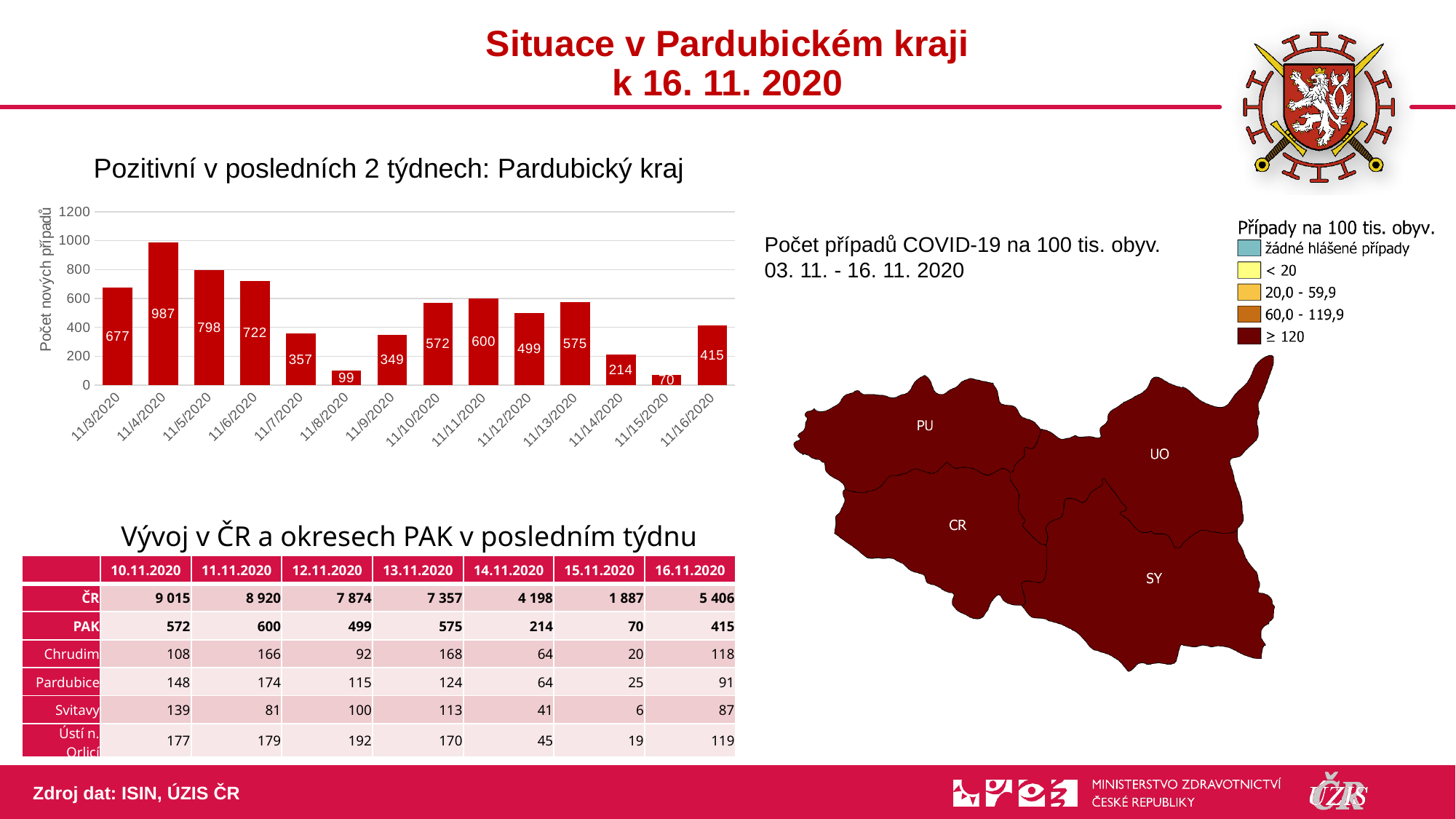
In the chart 'Pozitivní v posledních 2 týdnech: Pardubický kraj', which date has the lowest value? 11/15/2020 In the chart 'Pozitivní v posledních 2 týdnech: Pardubický kraj', is the value for 11/3/2020 greater or less than 600? greater In the chart 'Pozitivní v posledních 2 týdnech: Pardubický kraj', what is the value for 11/8/2020? 99 What type of chart is used for 'Pozitivní v posledních 2 týdnech: Pardubický kraj'? bar chart In the chart 'Pozitivní v posledních 2 týdnech: Pardubický kraj', which date has the highest value? 11/4/2020 In the chart 'Pozitivní v posledních 2 týdnech: Pardubický kraj', do the values rise or fall from 11/13/2020 to 11/15/2020? fall In the chart 'Pozitivní v posledních 2 týdnech: Pardubický kraj', what is the difference between the values for 11/4/2020 and 11/3/2020? 310 What is the y-axis title of the chart 'Pozitivní v posledních 2 týdnech: Pardubický kraj'? Počet nových případů How many dates (bars) are shown in the chart 'Pozitivní v posledních 2 týdnech: Pardubický kraj'? 14 In the chart 'Pozitivní v posledních 2 týdnech: Pardubický kraj', what is the value for 11/16/2020? 415 In the chart 'Pozitivní v posledních 2 týdnech: Pardubický kraj', which is larger, the value for 11/5/2020 or 11/6/2020? 11/5/2020 In the chart 'Pozitivní v posledních 2 týdnech: Pardubický kraj', what is the value for 11/4/2020? 987